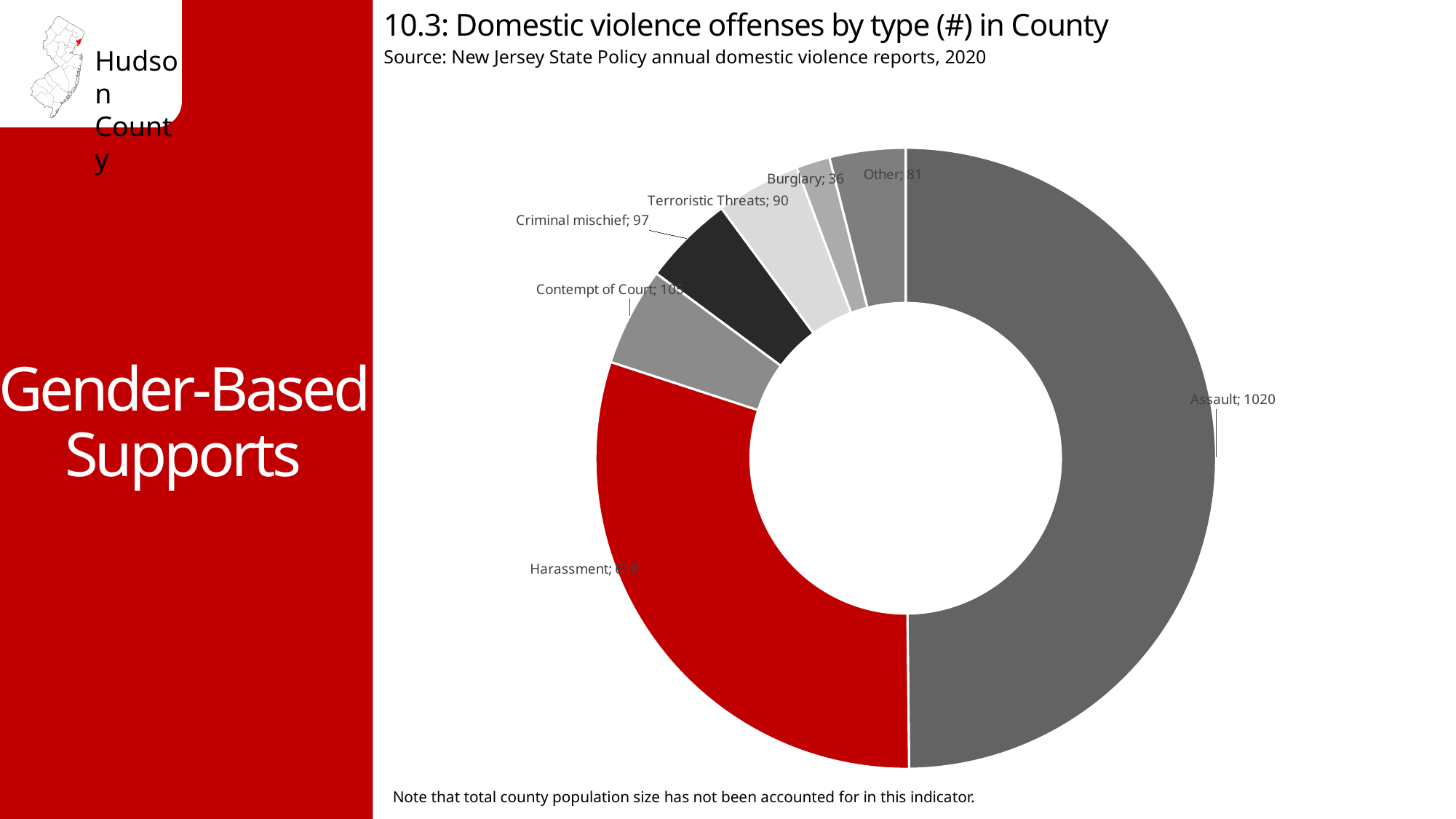
What is the value for Burglary? 36 Which offense type has the lowest number of offenses? Burglary How many offense types are shown in the chart? 7 What is the value for Terroristic Threats? 90 How many domestic violence offenses of type Assault are shown? 1020 What is the value for Criminal mischief? 97 What is the difference between the values for Assault and Other? 939 Which offense type has the highest number of offenses? Assault What is the difference between the values for Criminal mischief and Terroristic Threats? 7 What is the value for Other? 81 What kind of chart is shown on the slide? doughnut chart Which is larger, the value for Assault or the value for Harassment? Assault